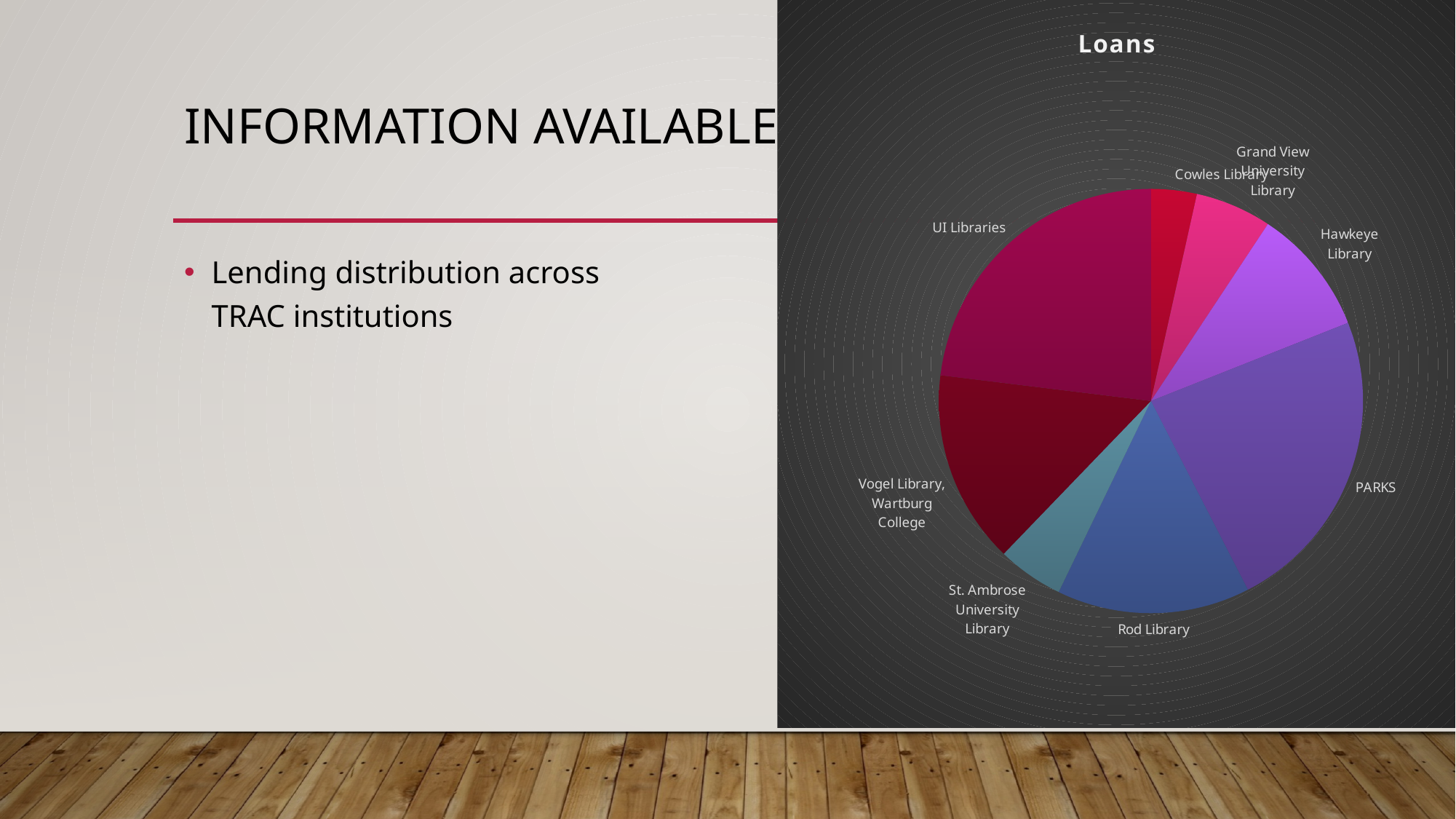
What kind of chart is shown on the slide? pie chart In the Loans pie chart, which slice is larger: Hawkeye Library or Grand View University Library? Hawkeye Library In the Loans pie chart, which slice is larger: UI Libraries or Rod Library? UI Libraries How many slices does the Loans pie chart have? 8 Which slice of the Loans pie chart is the smallest? Cowles Library In the Loans pie chart, which slice is larger: Vogel Library, Wartburg College or St. Ambrose University Library? Vogel Library, Wartburg College Which slice in the Loans pie chart is labelled with a college name in addition to the library name? Vogel Library, Wartburg College What is the title of the chart? Loans